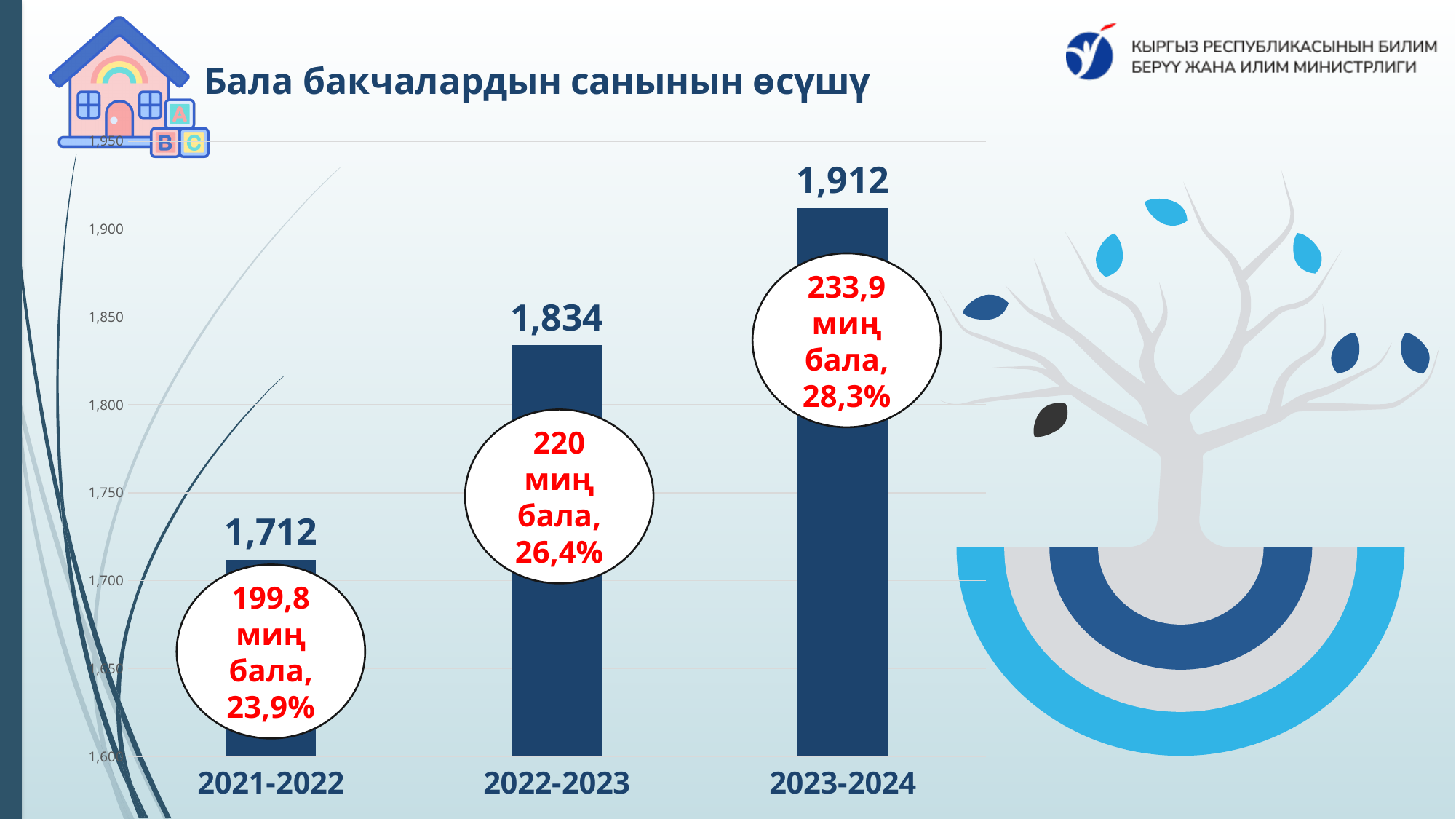
What is the difference between the values for 2023-2024 and 2021-2022? 200 Which period has the highest value? 2023-2024 Which period has the lowest value? 2021-2022 What is the value for 2022-2023? 1,834 Do the values rise or fall from 2021-2022 to 2023-2024? rise What percentage is shown in the circle on the 2023-2024 bar? 28,3% What kind of chart is shown on the slide? bar chart What is the value for 2023-2024? 1,912 What is the difference between the values for 2022-2023 and 2021-2022? 122 What is the value for 2021-2022? 1,712 Which is larger, the value for 2022-2023 or the value for 2023-2024? 2023-2024 How many periods are shown on the x axis? 3